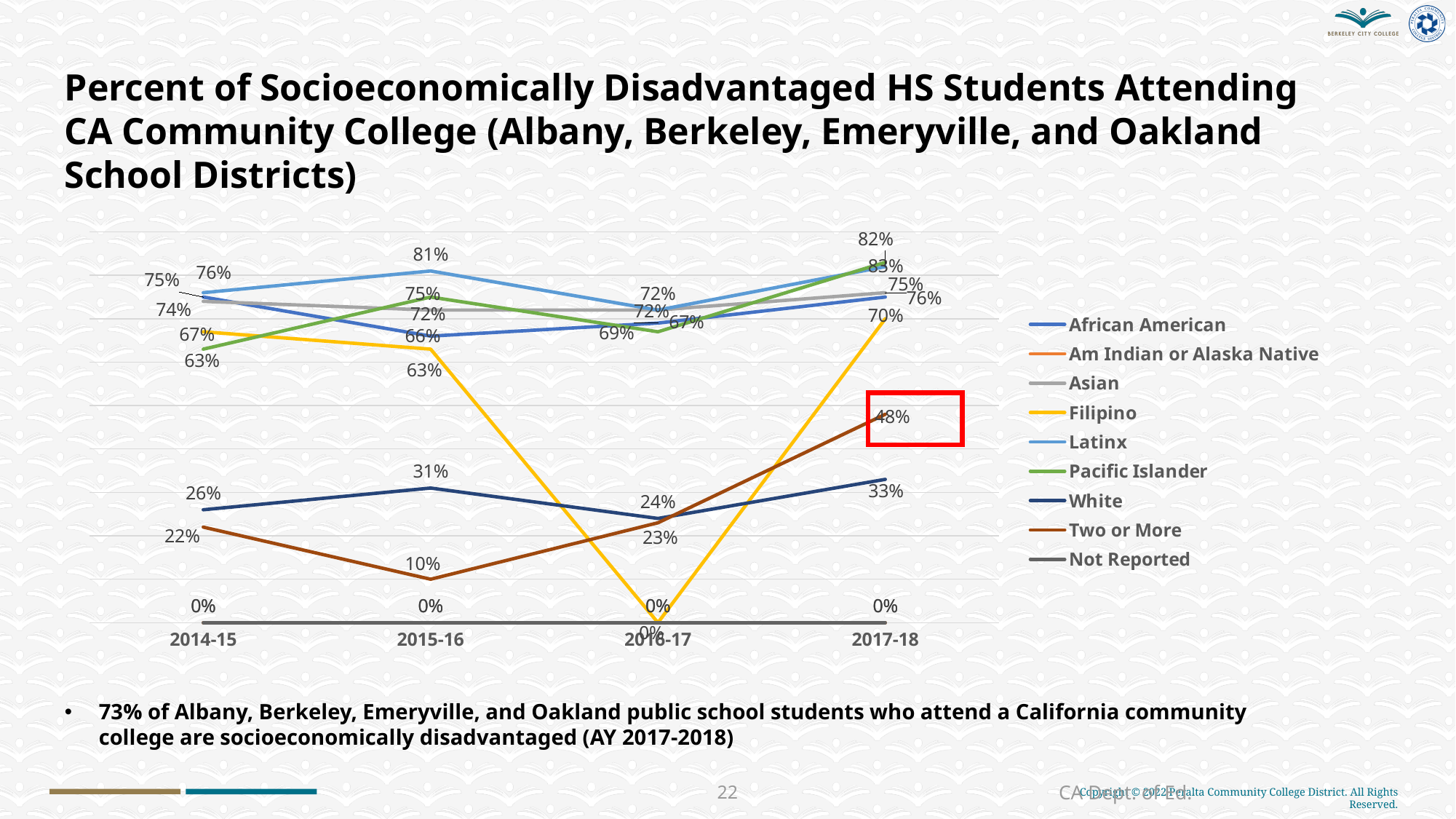
How many series does the legend list? 9 Which is larger in 2015-16, the value for White or the value for Two or More? White What is the difference between the Two or More value and the White value in 2017-18? 15 percentage points In which year is the White series at its highest? 2017-18 What is the value for Two or More in 2017-18? 48% How many academic years are shown on the x axis? 4 What type of chart is shown on the slide? Line chart Does the Two or More series rise or fall from 2015-16 to 2017-18? Rise What is the value for White in 2015-16? 31% What is the value for Filipino in 2016-17? 0% In which year is the Two or More series at its lowest? 2015-16 What is the value for Filipino in 2017-18? 70%